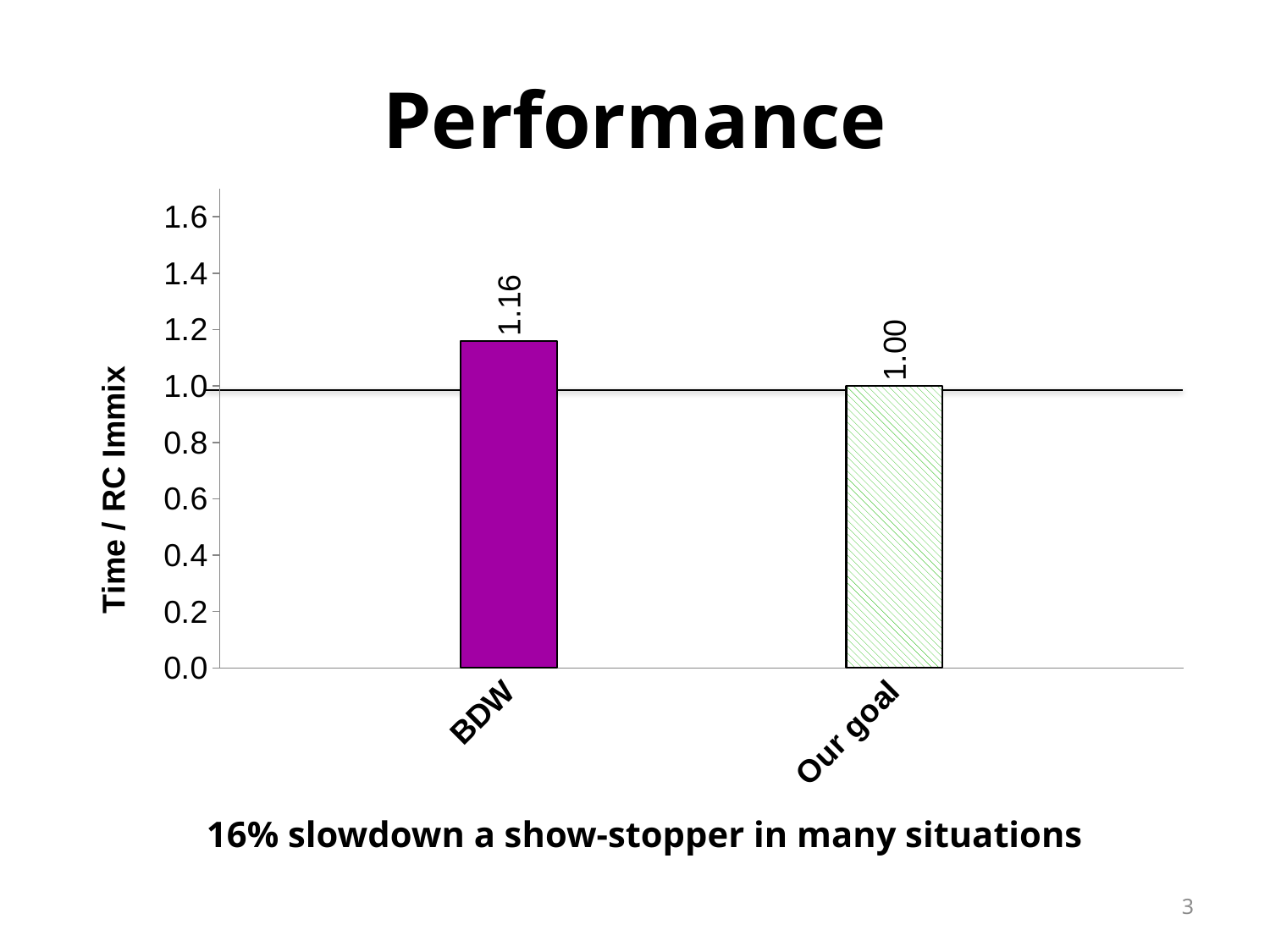
What is the value for Our goal? 1.00 Which category has the lowest value? Our goal What kind of chart is shown on the slide? bar chart Is the value for BDW greater or less than 1.0? greater What is the value for BDW? 1.16 What is the difference between the values for BDW and Our goal? 0.16 What is the title of the slide containing the chart? Performance What is the label of the y axis? Time / RC Immix How many categories are shown on the x axis? 2 Which is larger, the value for BDW or the value for Our goal? BDW Is the value for Our goal greater or less than 1.2? less Which category has the highest value? BDW